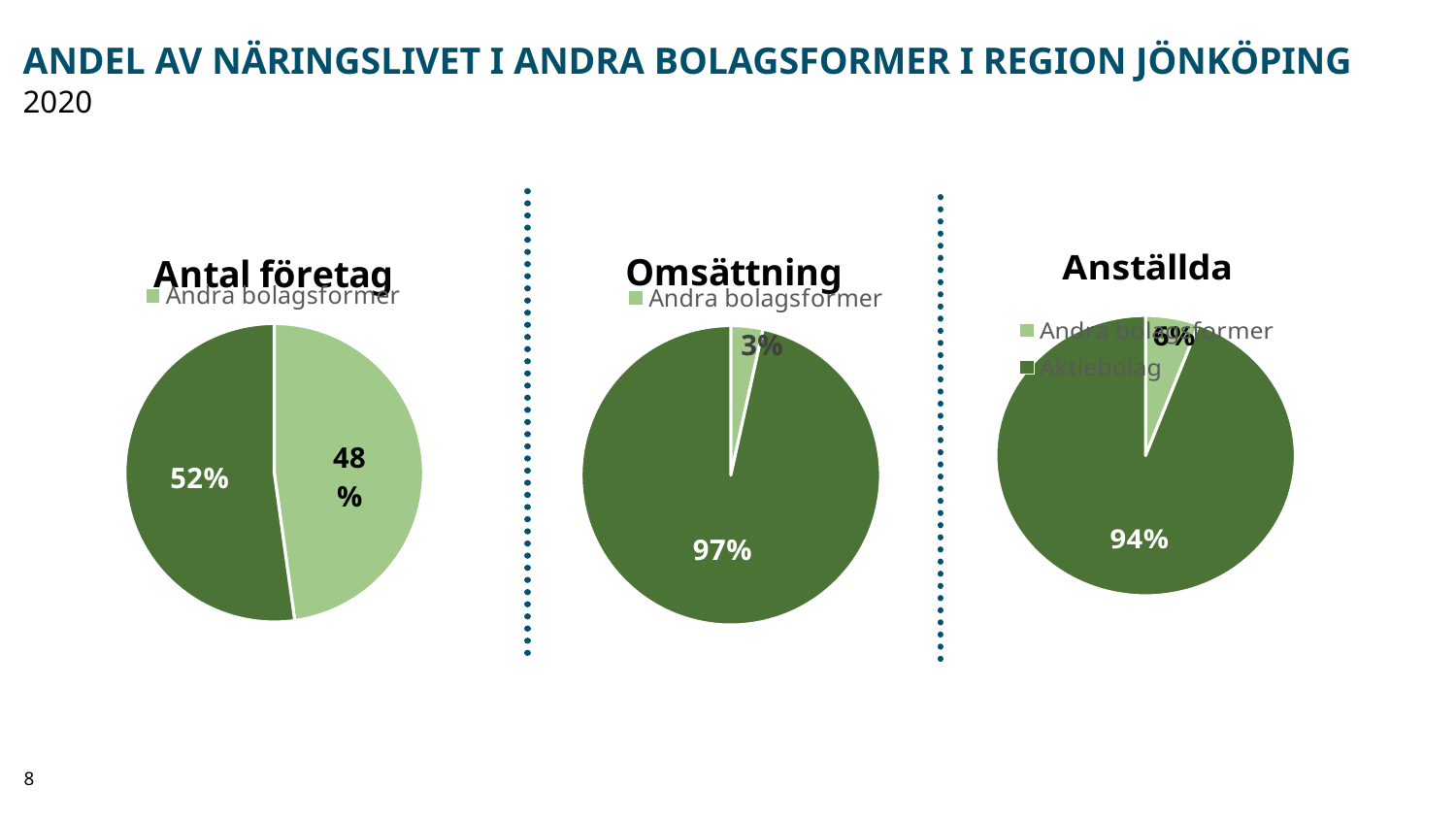
In the "Anställda" pie chart, what is the difference in percentage points between Aktiebolag and Andra bolagsformer? 88 percentage points In the "Anställda" pie chart, what share does Aktiebolag have? 94% In the "Antal företag" pie chart, what is the value of the larger (dark green) slice? 52% What kind of chart is the "Antal företag" chart? Pie chart In the "Omsättning" pie chart, what is the value of the larger (dark green) slice? 97% How many pie charts are shown on the slide? 3 How many slices does the "Omsättning" pie chart have? 2 In the "Omsättning" pie chart, what share does Andra bolagsformer have? 3% Is the share of Andra bolagsformer larger in the "Antal företag" chart or in the "Omsättning" chart? Antal företag Which two entries does the legend of the "Anställda" chart list? Andra bolagsformer and Aktiebolag In the "Anställda" pie chart, what share does Andra bolagsformer have? 6%